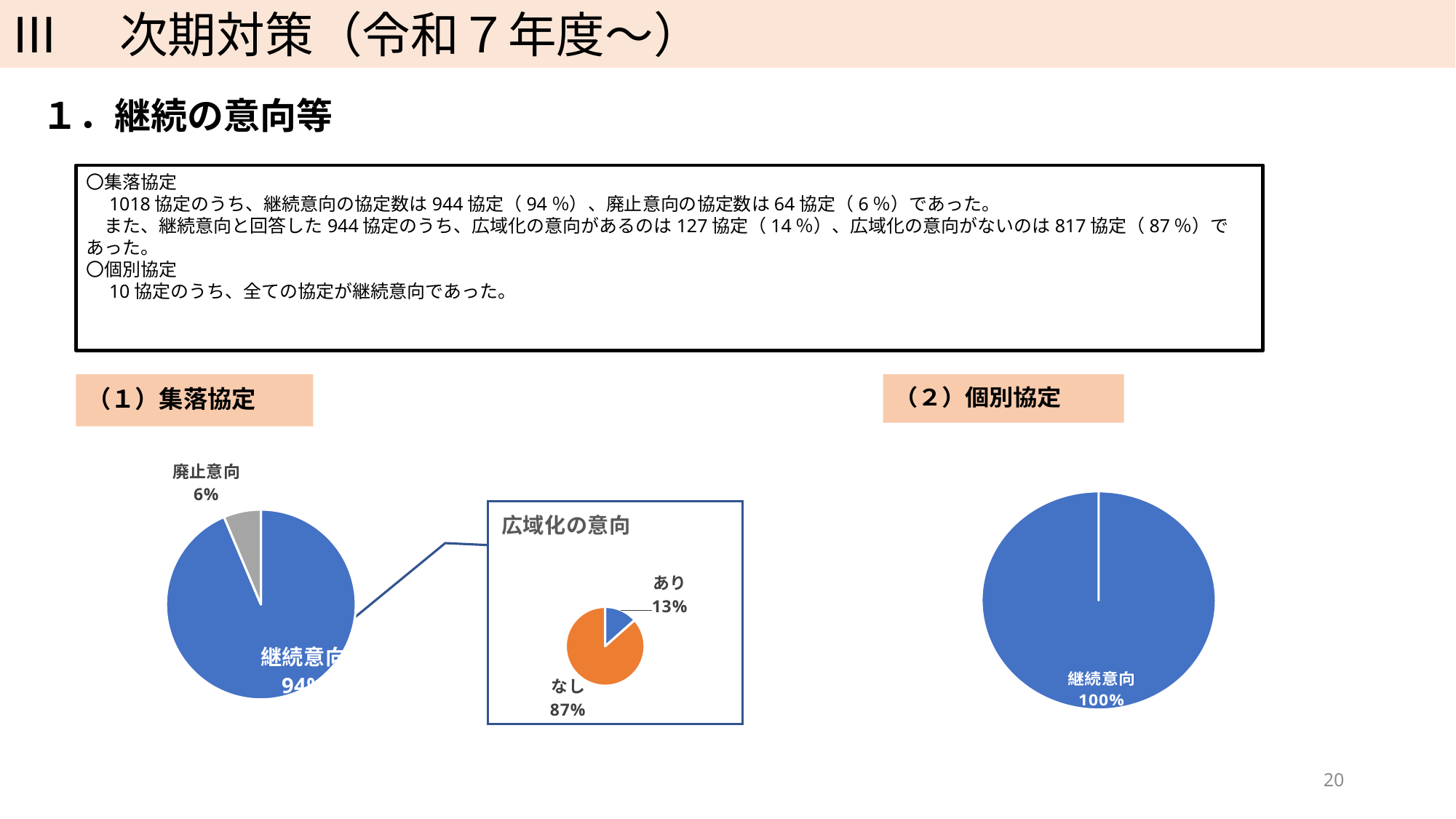
What type of chart is used under (2) 個別協定? Pie chart In the (1) 集落協定 pie chart, what share is labelled for 継続意向? 94% In the (1) 集落協定 pie chart, which slice is the largest? 継続意向 In the 広域化の意向 pie chart, what is the difference in percentage points between なし and あり? 74 In the 広域化の意向 pie chart, what colour is the なし slice? Orange In the 広域化の意向 pie chart, which slice is larger, あり or なし? なし In the (1) 集落協定 pie chart, which slice is the smallest? 廃止意向 In the (2) 個別協定 pie chart, what share is labelled for 継続意向? 100% In the (1) 集落協定 pie chart, how many slices are there? 2 In the (1) 集落協定 pie chart, what share is labelled for 廃止意向? 6%